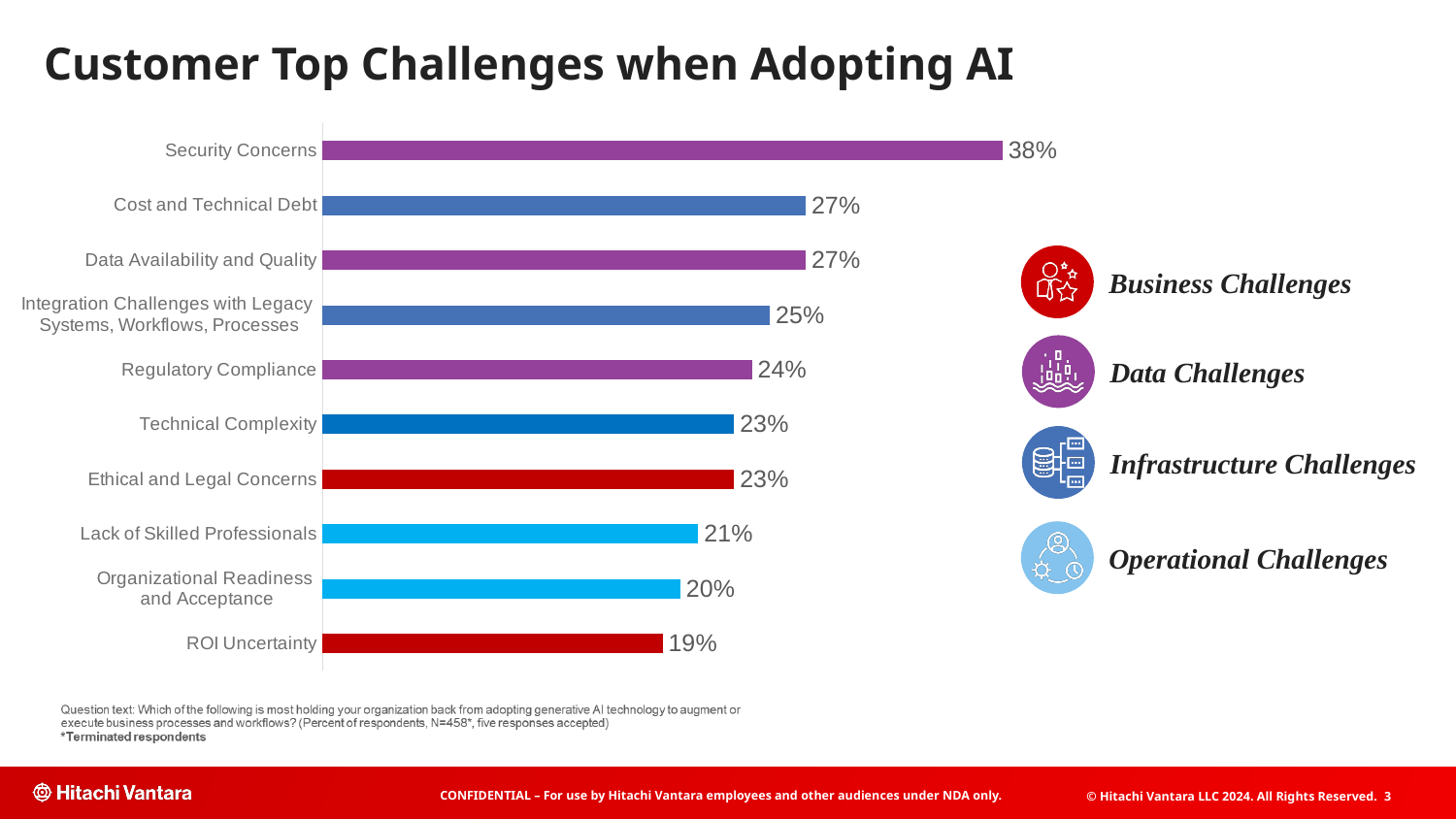
What is the value for Security Concerns? 38% What is the value for Lack of Skilled Professionals? 21% What kind of chart is shown on the slide? Bar chart How many challenges are shown in the chart? 10 What is the difference between the values for Technical Complexity and ROI Uncertainty? 4% Which is larger, the value for Regulatory Compliance or the value for Organizational Readiness and Acceptance? Regulatory Compliance Which challenge has the lowest value? ROI Uncertainty Which challenge has the highest value? Security Concerns What is the value for Integration Challenges with Legacy Systems, Workflows, Processes? 25% What is the value for Regulatory Compliance? 24% What is the title of the slide? Customer Top Challenges when Adopting AI What is the difference between the values for Security Concerns and Cost and Technical Debt? 11%